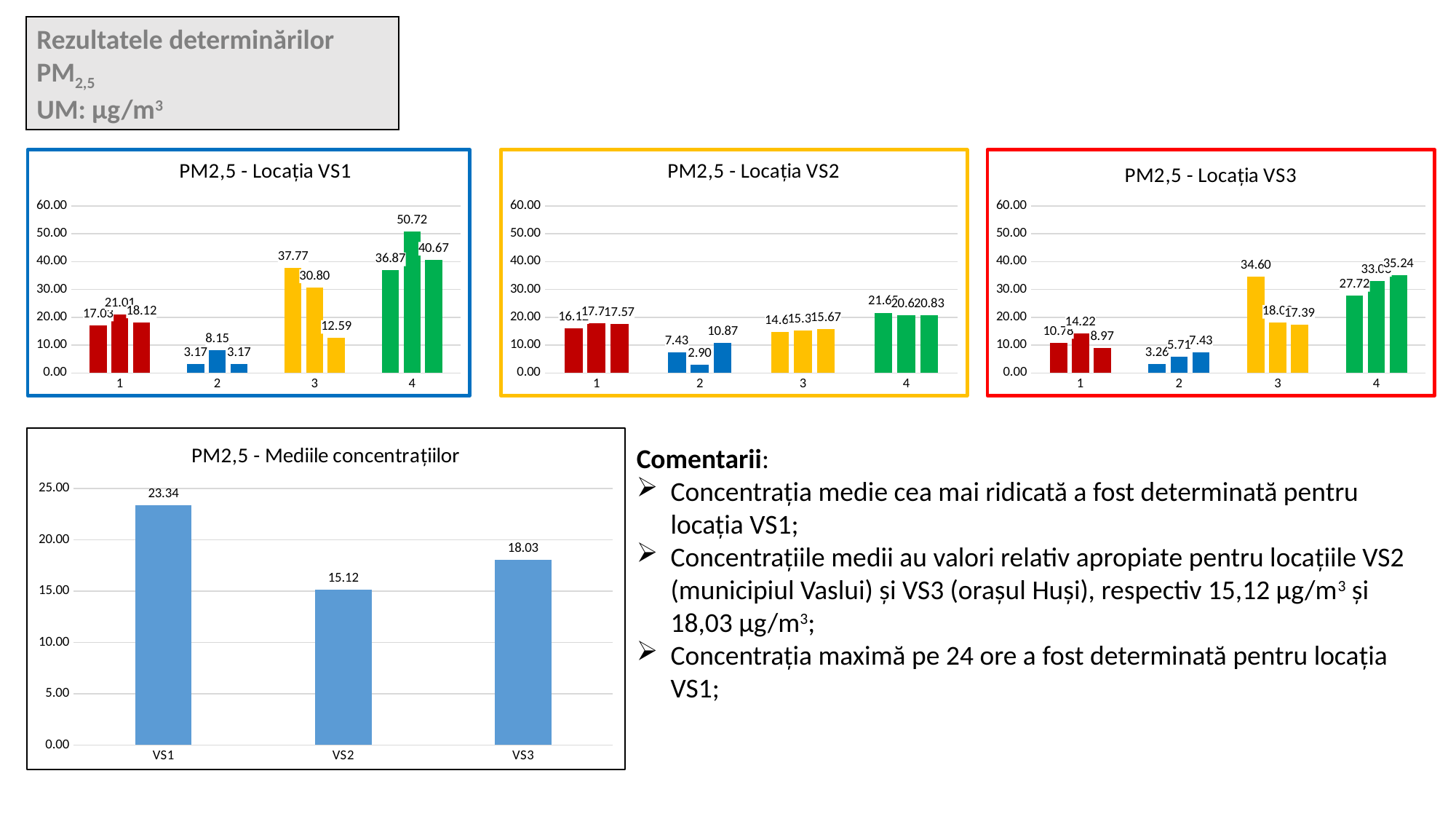
In the chart 'PM2,5 - Mediile concentrațiilor', how many bars are plotted? 3 In the chart 'PM2,5 - Locația VS1', what is the value of the middle (blue) bar in group 2? 8.15 In the chart 'PM2,5 - Locația VS2', what is the value of the third (blue) bar in group 2? 10.87 In the chart 'PM2,5 - Locația VS1', what is the highest value shown in group 4? 50.72 In the chart 'PM2,5 - Locația VS1', what is the difference between the first and third bars in group 3 (37.77 and 12.59)? 25.18 In the chart 'PM2,5 - Locația VS3', which is larger: the first bar in group 4 (27.72) or the third bar in group 4 (35.24)? 35.24 In the chart 'PM2,5 - Mediile concentrațiilor', what is the value for VS1? 23.34 In the chart 'PM2,5 - Mediile concentrațiilor', which location has the lowest value? VS2 In the chart 'PM2,5 - Mediile concentrațiilor', what is the difference between the values for VS1 and VS3? 5.31 In the chart 'PM2,5 - Locația VS2', is the value of the middle bar in group 2 greater or less than 10.00? less In the chart 'PM2,5 - Locația VS3', what is the value of the first (yellow) bar in group 3? 34.60 What kind of chart is 'PM2,5 - Mediile concentrațiilor'? bar chart